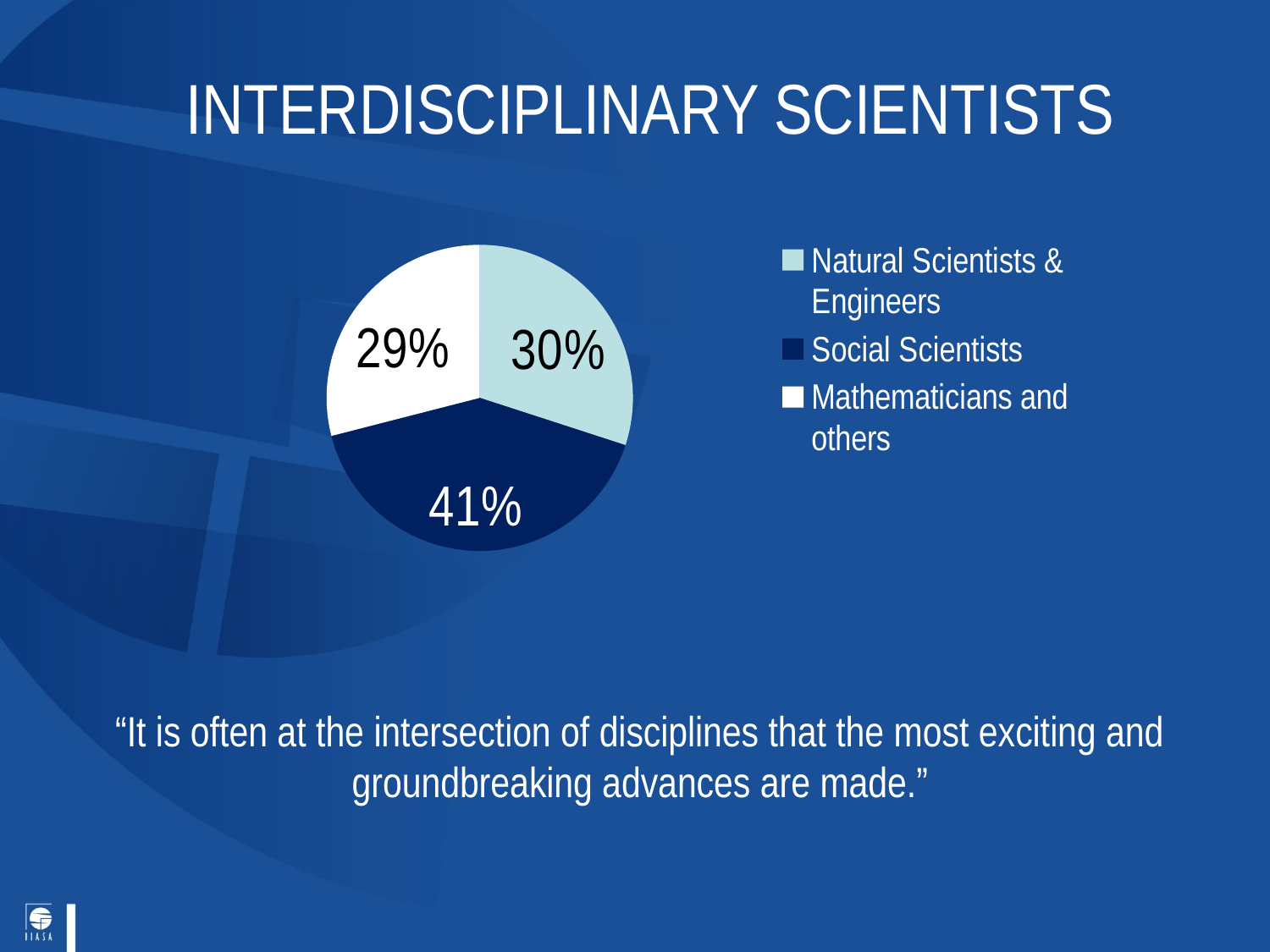
What is the difference in percentage points between Natural Scientists & Engineers and Mathematicians and others? 1 What share of the pie is Natural Scientists & Engineers? 30% Which legend entry is shown in white? Mathematicians and others What kind of chart is shown on the slide? pie chart What share of the pie is Social Scientists? 41% Which category has the largest slice of the pie? Social Scientists How many entries does the legend list? 3 What is the difference in percentage points between Social Scientists and Natural Scientists & Engineers? 11 What share of the pie is Mathematicians and others? 29% Which is larger, the share for Social Scientists or the share for Mathematicians and others? Social Scientists Which category has the smallest slice of the pie? Mathematicians and others How many slices does the pie chart have? 3